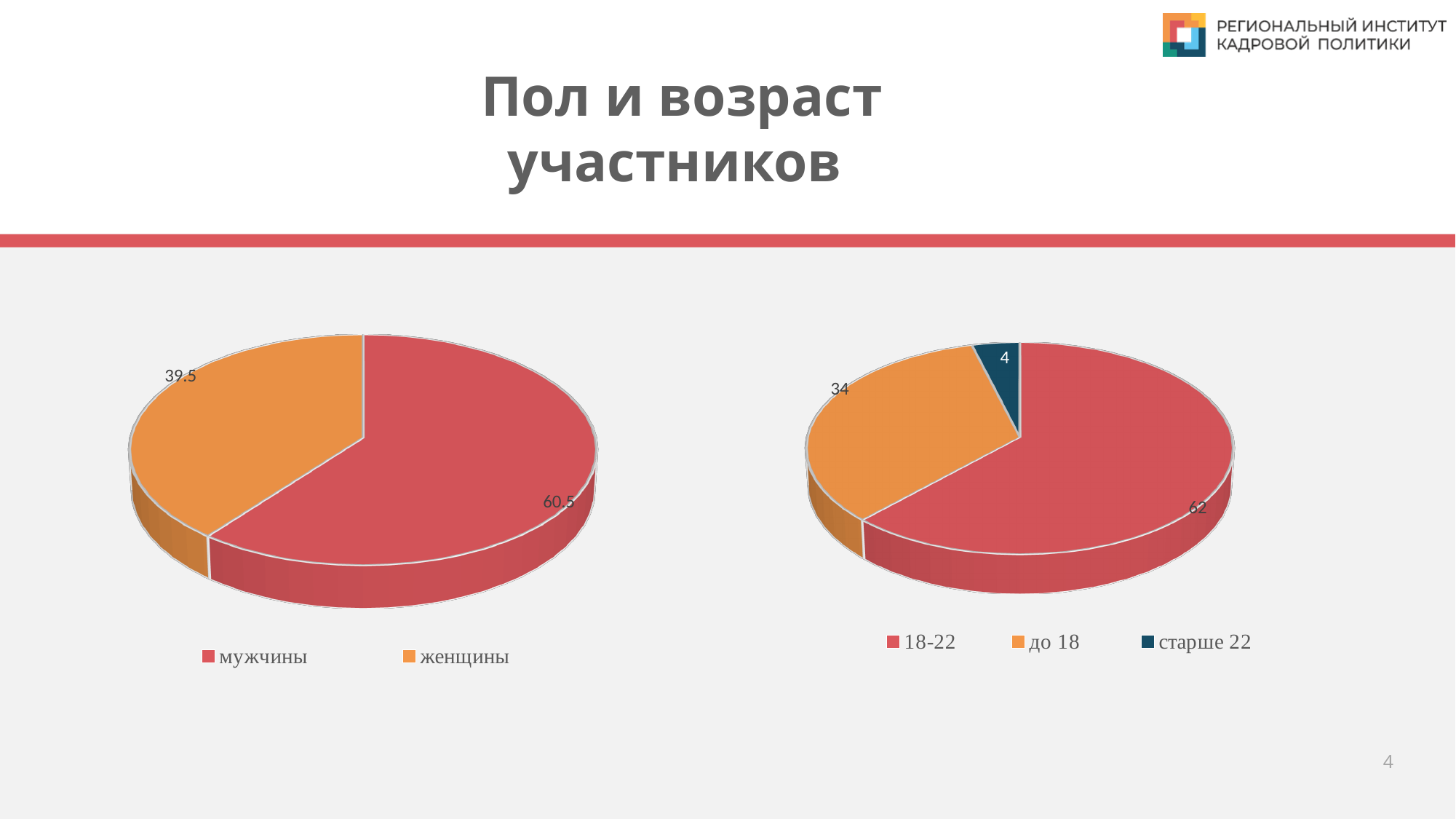
In the left pie chart, what is the difference between the values for мужчины and женщины? 21 In the right pie chart, what is the value for до 18? 34 In the right pie chart, what is the value for 18-22? 62 In the left pie chart, what is the value for женщины? 39.5 In the right pie chart, what is the difference between the values for 18-22 and до 18? 28 In the right pie chart, which category has the largest slice? 18-22 In the right pie chart, which category has the smallest slice? старше 22 In the left pie chart, which is larger, мужчины or женщины? мужчины In the left pie chart, what is the value for мужчины? 60.5 What kind of chart is the left chart on the slide? pie chart In the right pie chart, what is the value for старше 22? 4 How many categories does the right pie chart show? 3